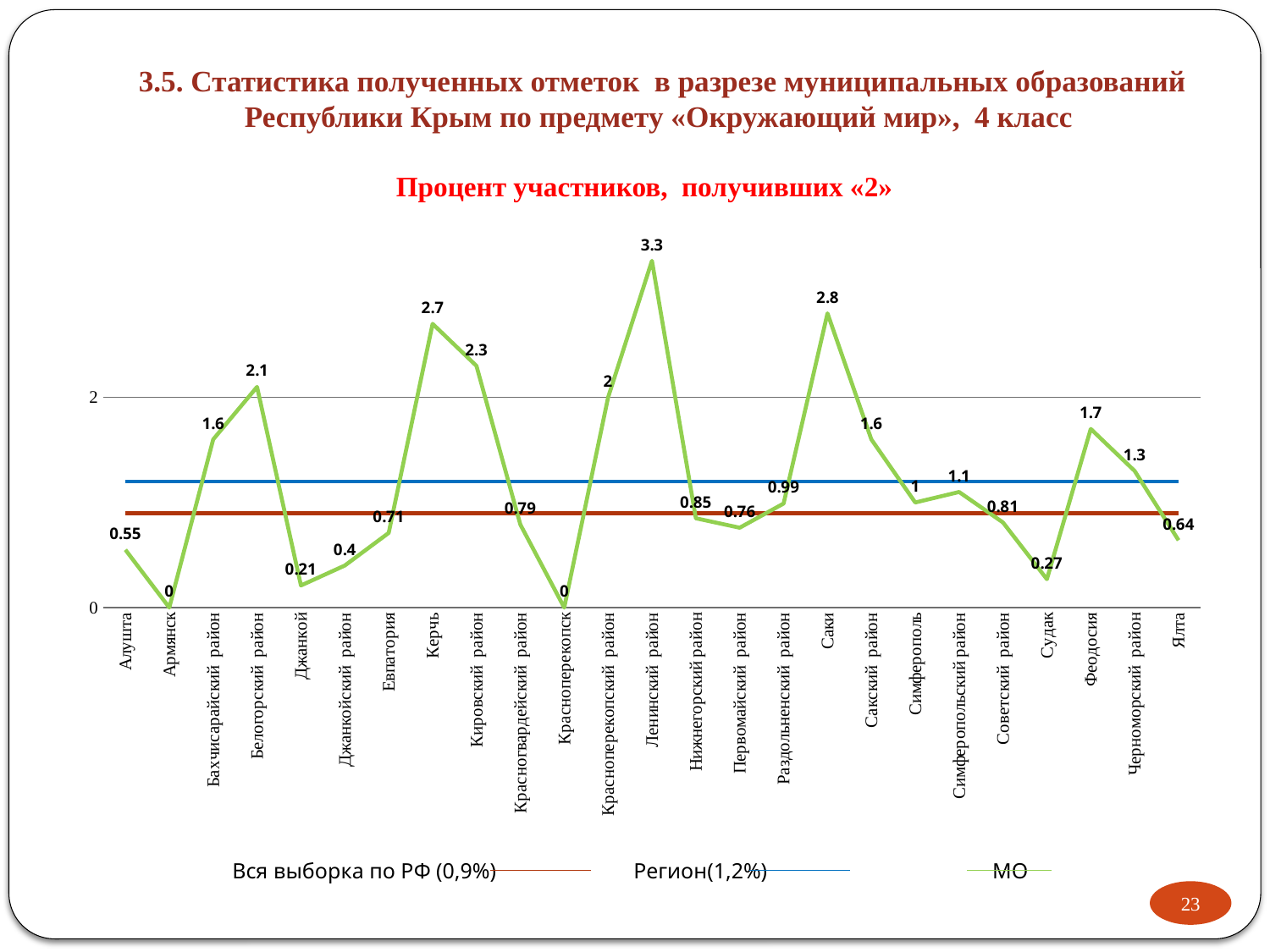
What is the value for Ленинский район? 3.3 How many series does the legend list? 3 What is the difference between the values for Феодосия and Черноморский район? 0.4 Which is larger, the value for Белогорский район or for Бахчисарайский район? Белогорский район Is the value for Кировский район greater or less than 2? greater Which municipality has the highest value? Ленинский район How many municipalities are plotted along the x axis? 25 What is the difference between the values for Саки and Керчь? 0.1 What is the value for Керчь? 2.7 What is the value for Ялта? 0.64 What is the value for Судак? 0.27 What type of chart is shown on the slide? line chart